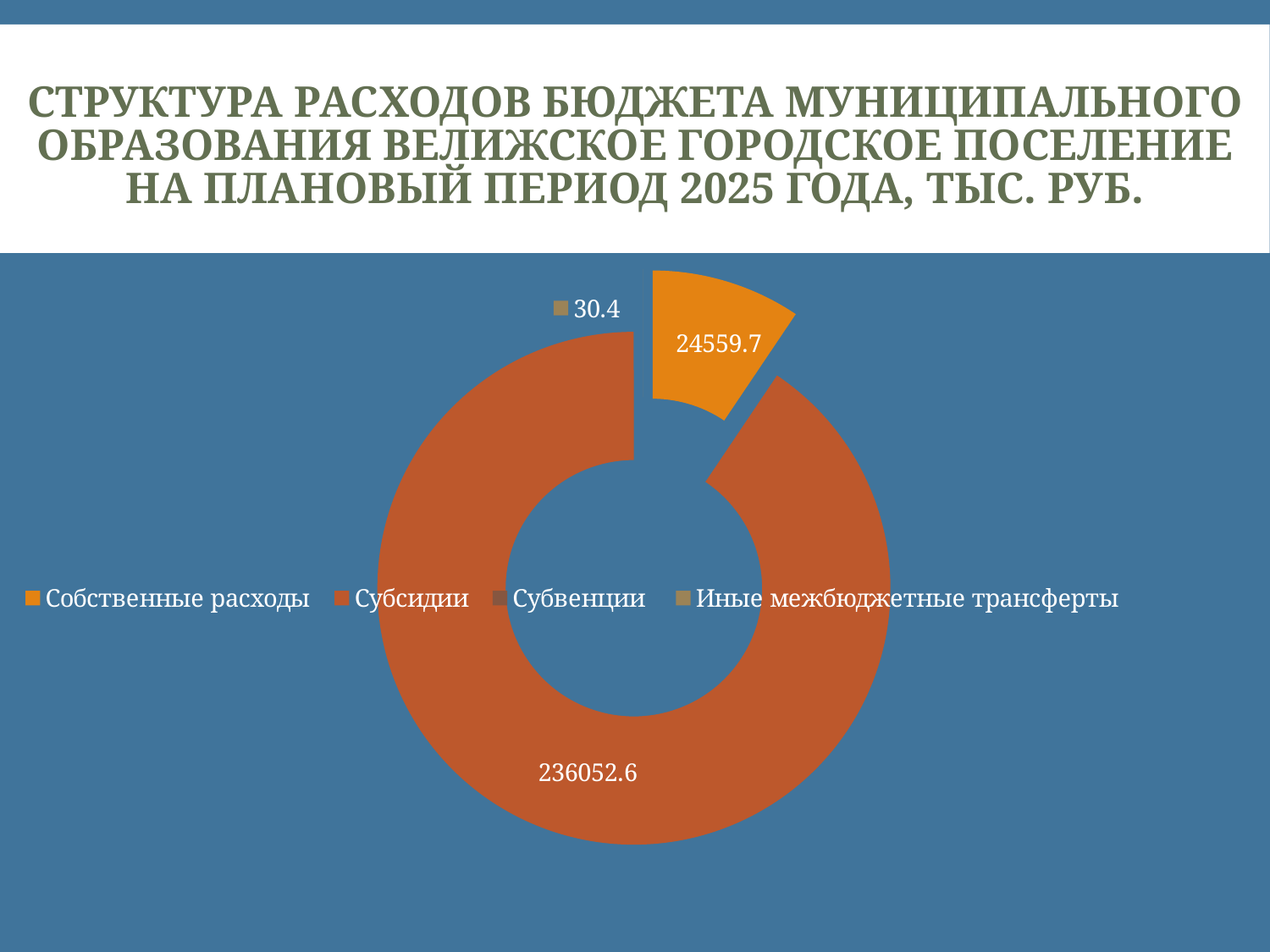
Which category has the largest value? Субсидии Which labelled category has the smallest value? Иные межбюджетные трансферты What value is shown for Субсидии? 236052.6 In what units are the values on the slide expressed, according to the title? тыс. руб. Which is larger, Собственные расходы or Субсидии? Субсидии What kind of chart is shown on the slide? Doughnut chart What colour is the Субсидии segment? Red-orange How many categories does the legend list? 4 What value is shown for Иные межбюджетные трансферты? 30.4 What value is shown for Собственные расходы? 24559.7 What is the difference between the values for Собственные расходы and Иные межбюджетные трансферты? 24529.3 What is the difference between the values for Субсидии and Собственные расходы? 211492.9